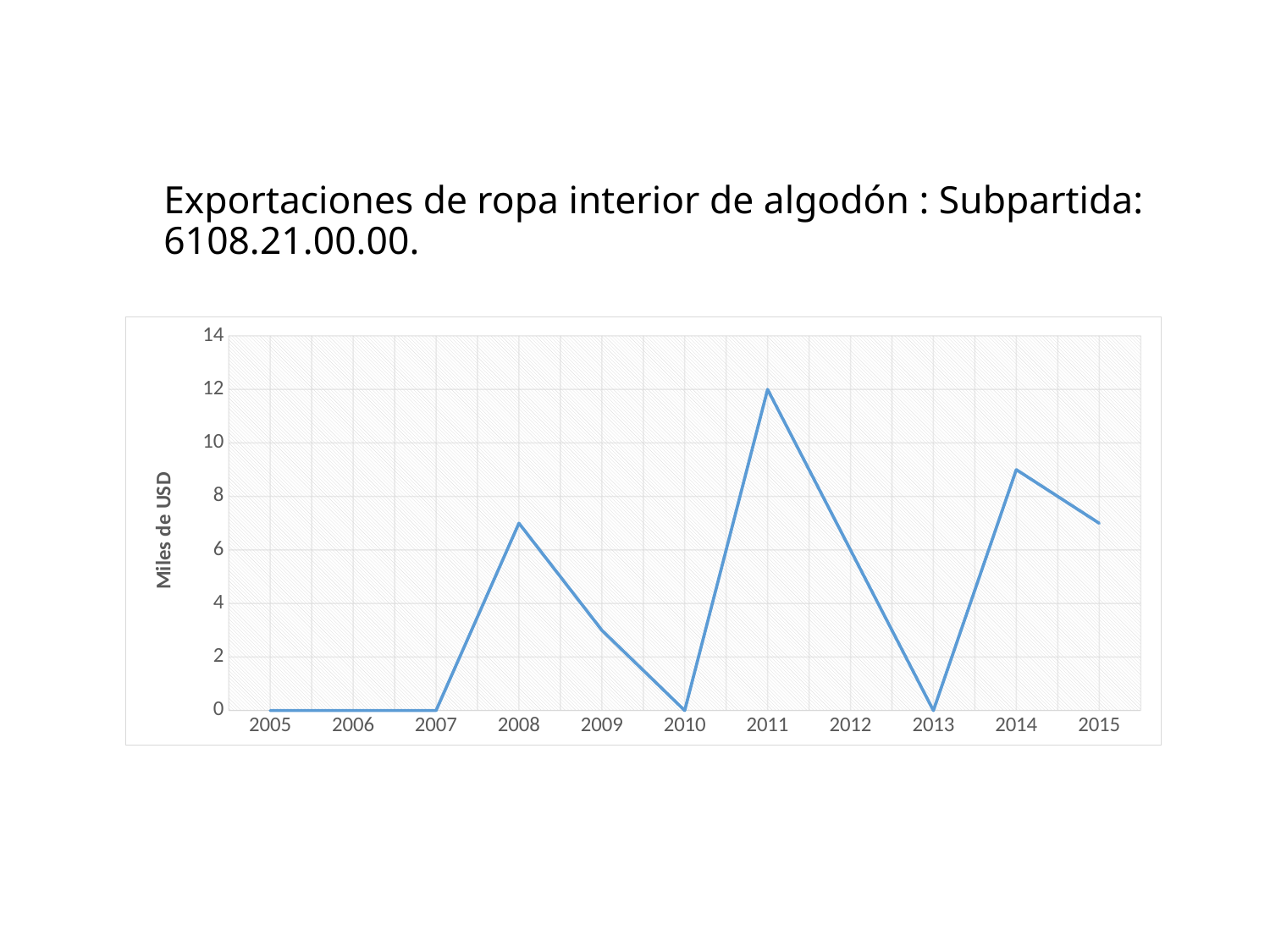
Which year has the highest value? 2011 Is the value for 2015 greater or less than 10? less Is the value for 2008 greater or less than 4? greater Does the value rise or fall from 2014 to 2015? fall What is the value for 2011? 12 What is the label of the vertical axis? Miles de USD What is the difference between the values for 2011 and 2012? 6 What kind of chart is shown on the slide? line chart Which is larger, the value for 2011 or the value for 2014? 2011 What is the value for 2012? 6 How many years are shown on the x axis? 11 What is the value for 2013? 0